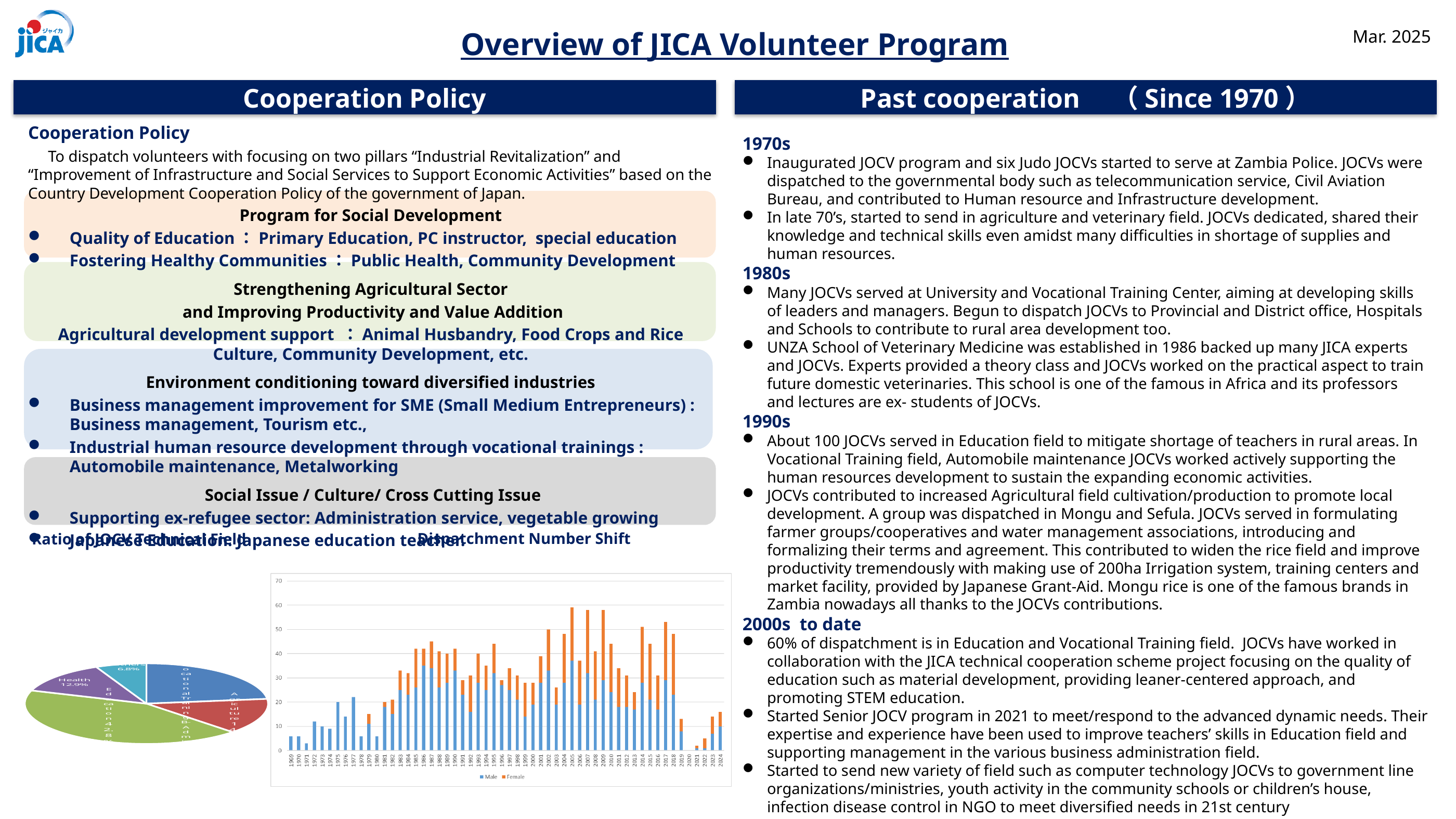
In the Dispatchment Number Shift chart, what kind of chart is used? bar chart In the pie chart on the left, how many slices are there? 5 In the Dispatchment Number Shift chart, how many series does the legend list? 2 In the Dispatchment Number Shift chart, do the total values generally rise or fall from 1969 to 1986? rise In the pie chart on the left, what share is shown for Health? 12.9% In the Dispatchment Number Shift chart, which year has the larger total bar, 1969 or 2005? 2005 In the pie chart on the left, what kind of chart is used? pie chart In the Dispatchment Number Shift chart, what are the two series named in the legend? Male and Female In the Dispatchment Number Shift chart, which colour represents the Female series? orange In the Dispatchment Number Shift chart, is the total value for 2005 greater or less than 50? greater In the Dispatchment Number Shift chart, is the total value for 1969 greater or less than 10? less In the Dispatchment Number Shift chart, is the total value for 1986 greater or less than 30? greater